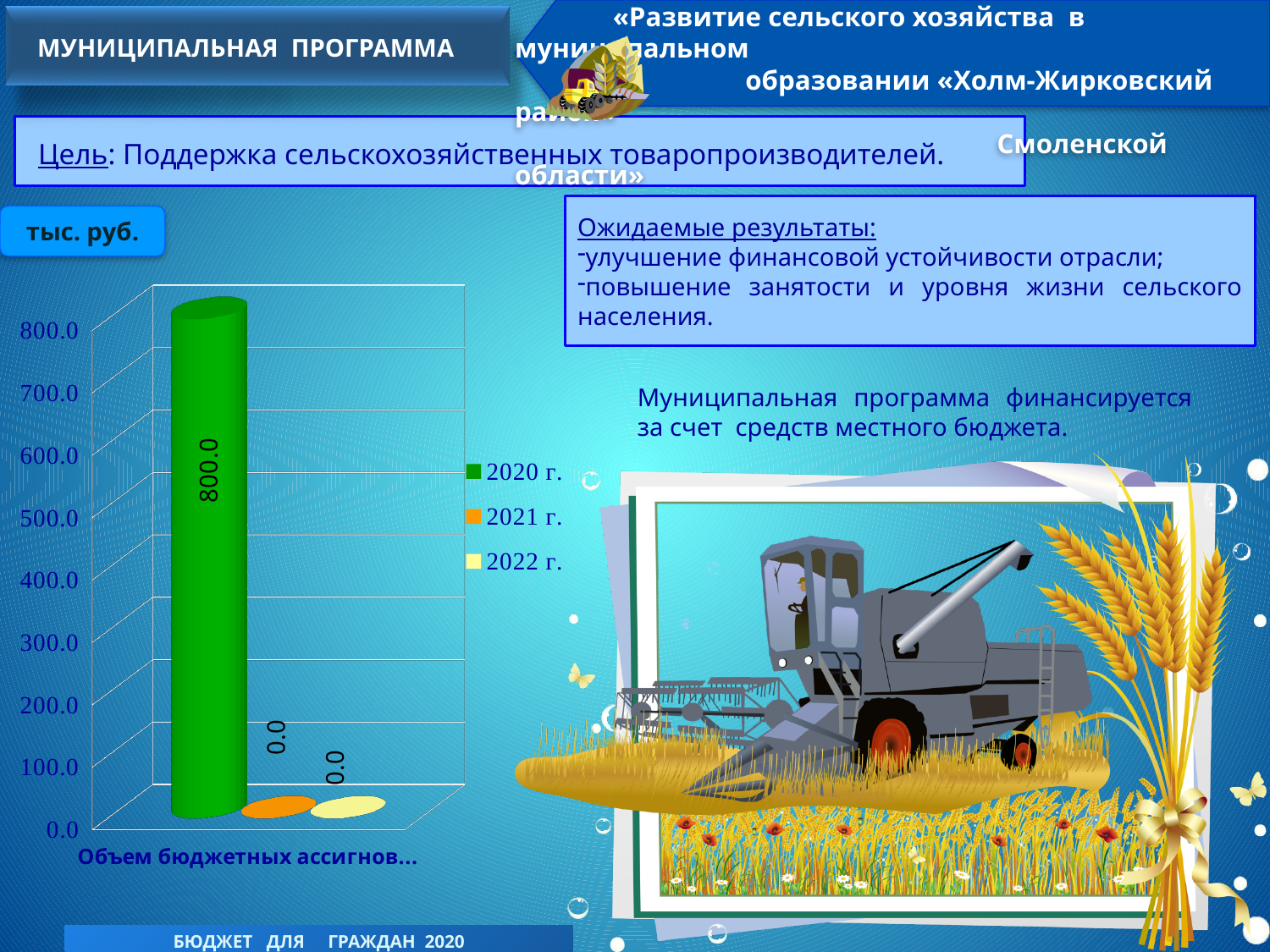
What is the value for the 2022 г. series in the chart? 0.0 What is the value for the 2021 г. series in the chart? 0.0 Is the value for 2020 г. greater or less than 700.0? greater What is the difference between the 2020 г. value and the 2021 г. value? 800.0 What unit is indicated for the chart values? тыс. руб. What is the value for the 2020 г. series in the chart? 800.0 What is the total of the values for 2020 г., 2021 г. and 2022 г.? 800.0 What colour is the bar for the 2020 г. series? green Which series has the highest value in the chart? 2020 г. What kind of chart is shown on the slide? bar chart Which is larger, the value for 2020 г. or the value for 2022 г.? 2020 г. How many series does the chart legend list? 3